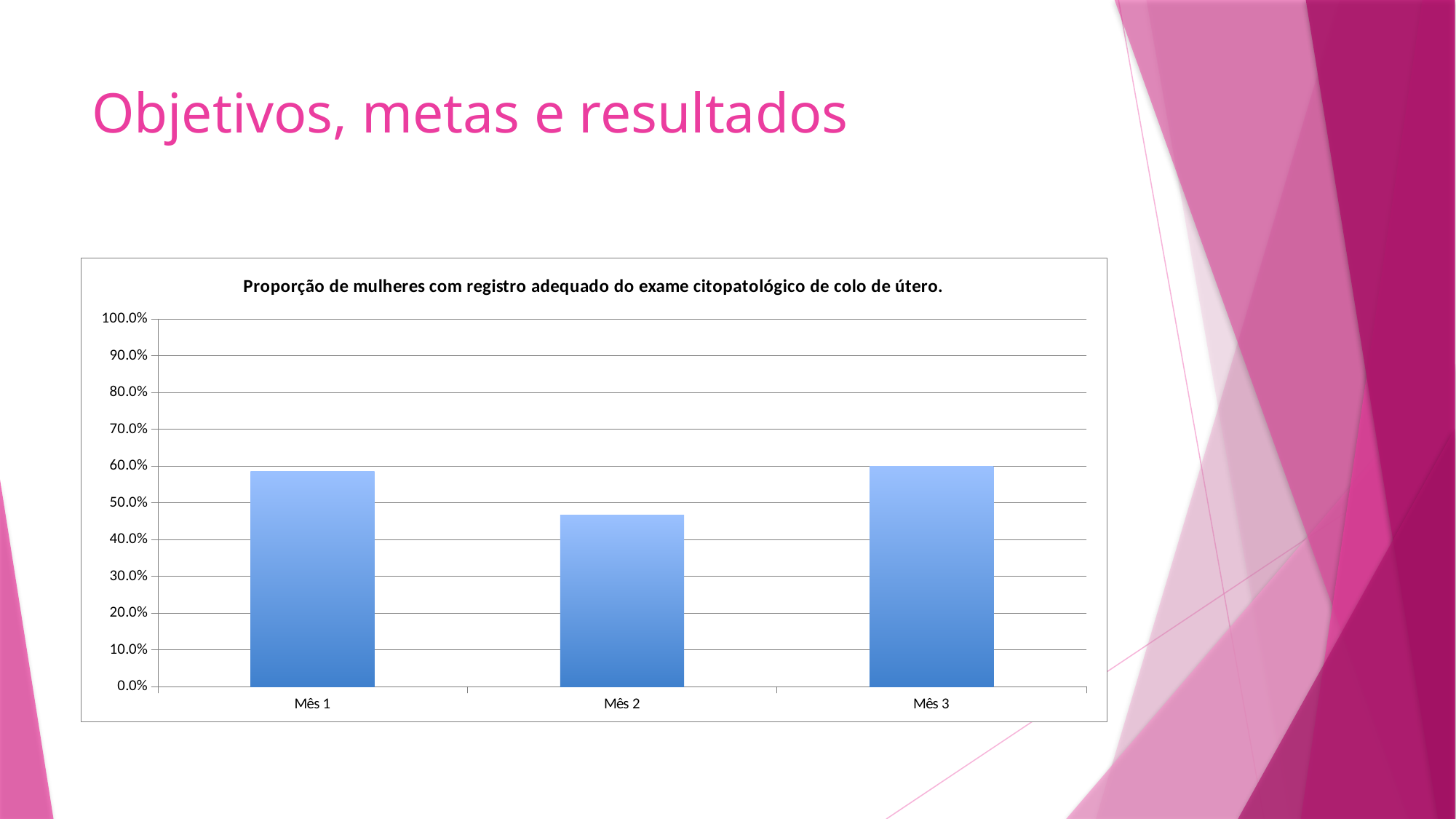
Which month has the lowest value? Mês 2 Which is larger, the value for Mês 2 or the value for Mês 3? Mês 3 Is the value for Mês 1 greater or less than 50.0%? greater What is the title of the chart? Proporção de mulheres com registro adequado do exame citopatológico de colo de útero. What kind of chart is shown on the slide? bar chart Does the value rise or fall from Mês 1 to Mês 2? fall How many categories are plotted on the x axis? 3 Is the value for Mês 3 greater or less than 50.0%? greater Is the value for Mês 2 greater or less than 40.0%? greater Does the value rise or fall from Mês 2 to Mês 3? rise